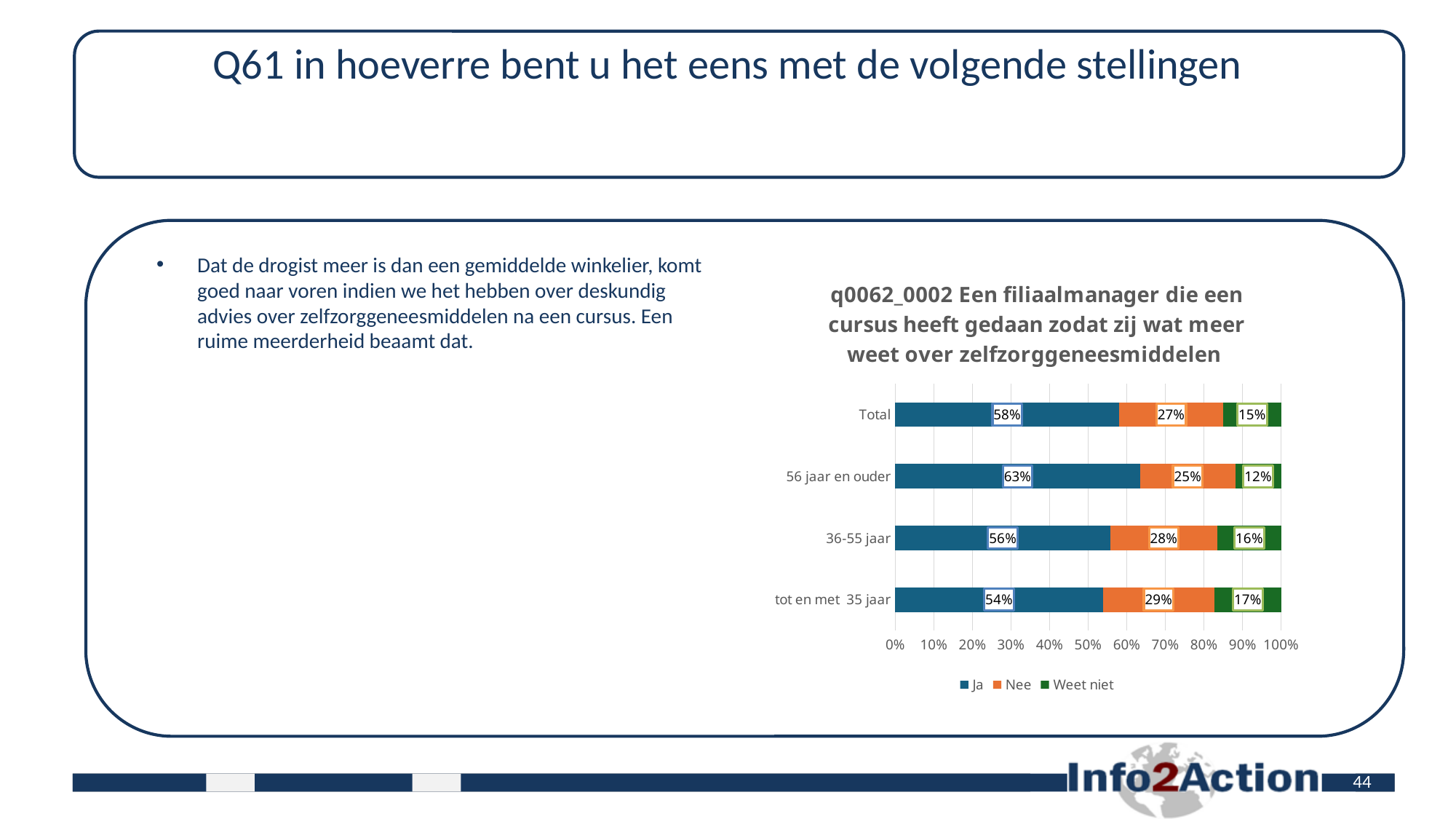
How many categories are shown on the chart? 4 What is the 'Nee' value for '36-55 jaar'? 28% Which is larger: the 'Nee' value for 'tot en met 35 jaar' or for '56 jaar en ouder'? tot en met 35 jaar What kind of chart is shown on the slide? stacked bar chart What is the difference between the 'Ja' values for '56 jaar en ouder' and 'tot en met 35 jaar'? 9% How many series does the legend list? 3 Which category has the highest 'Ja' value? 56 jaar en ouder What is the 'Weet niet' value for 'tot en met 35 jaar'? 17% What is the total of the stacked bar for '36-55 jaar'? 100% Which category has the lowest 'Weet niet' value? 56 jaar en ouder Which series is shown in orange in the legend? Nee What is the 'Ja' value for 'Total'? 58%